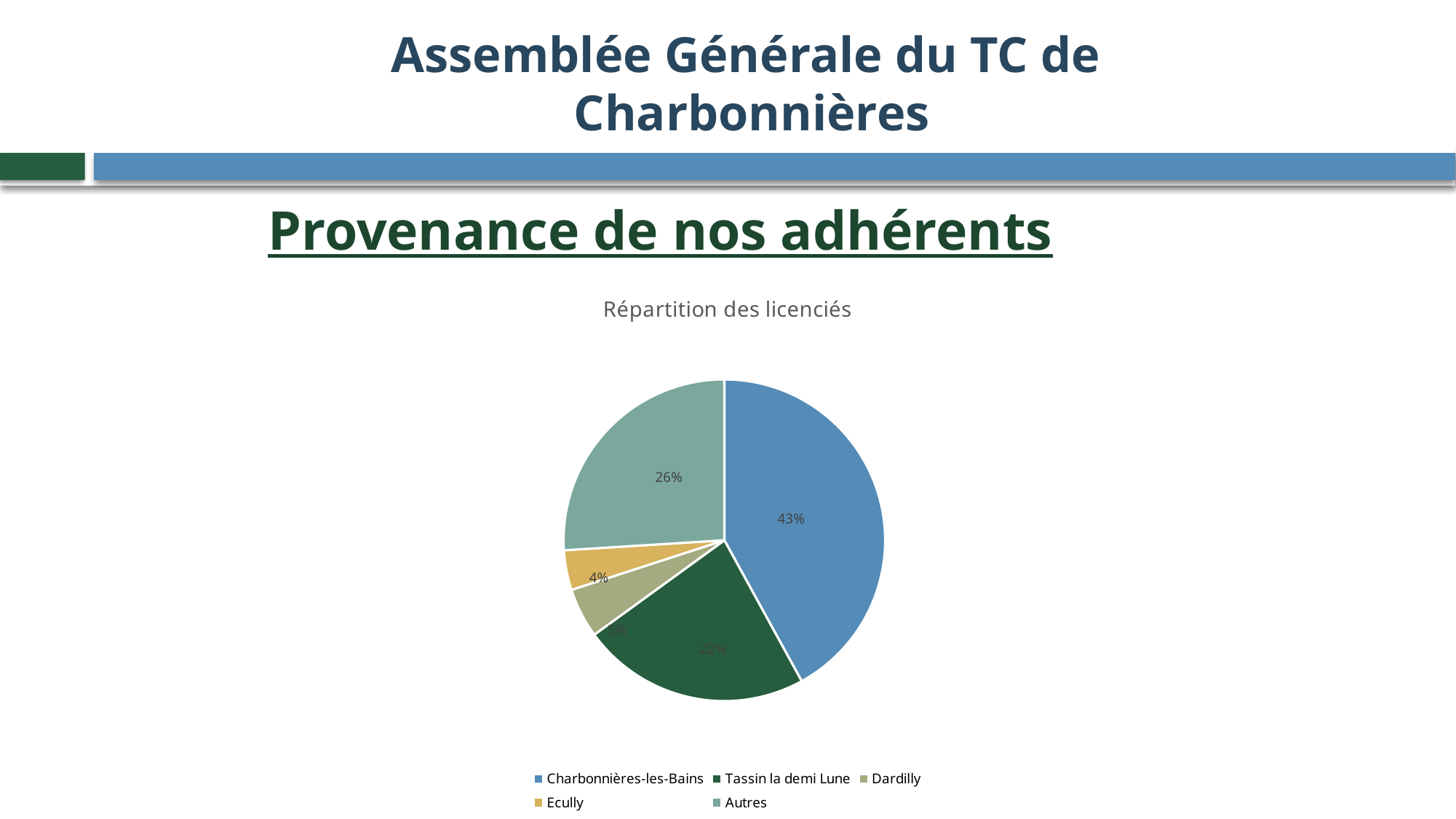
Which category has the largest slice of the pie? Charbonnières-les-Bains What share of the pie does Charbonnières-les-Bains represent? 43% What share of the pie does Autres represent? 26% What is the title of the chart? Répartition des licenciés What share of the pie does Tassin la demi Lune represent? 22% Which is larger, the share for Autres or the share for Tassin la demi Lune? Autres What colour is the slice for Ecully? yellow How many categories does the legend list? 5 What type of chart is shown on the slide? pie chart Which category has the smallest slice of the pie? Ecully What is the difference between the share for Charbonnières-les-Bains and the share for Autres? 17%